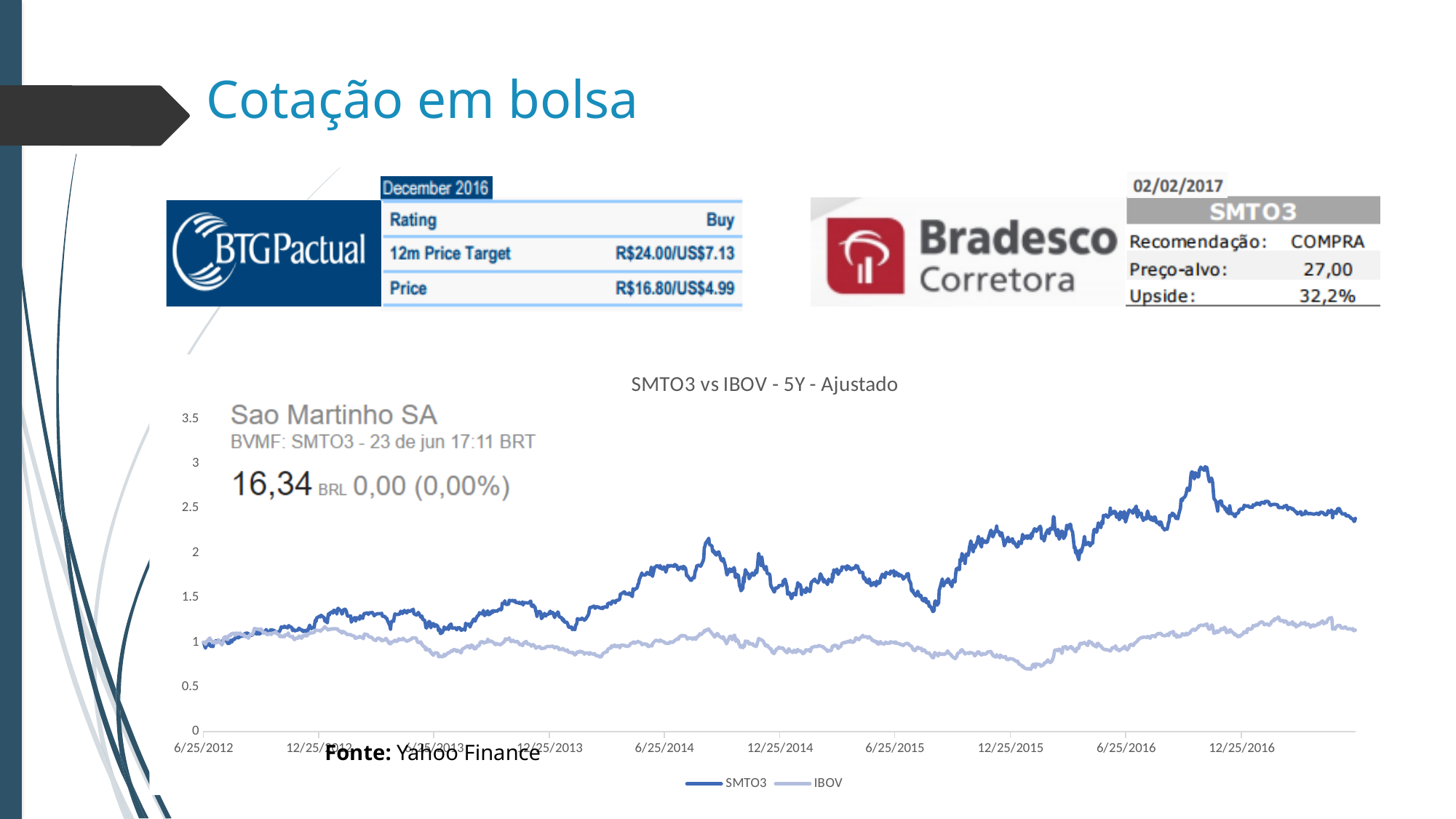
How many series does the legend of the chart list? 2 Is the value of SMTO3 at 6/25/2014 greater or less than 1.5? greater Which series is higher at the right end of the chart, SMTO3 or IBOV? SMTO3 Is the value of SMTO3 at the right end of the chart greater or less than 2? greater Does the SMTO3 series overall rise or fall from 6/25/2012 to the end of the chart? rise Is the value of IBOV around 12/25/2015 greater or less than 1? less What is the highest tick value shown on the y axis of the chart? 3.5 What kind of chart is shown on the slide? line chart Which series reaches the highest value on the chart? SMTO3 What is the title of the chart? SMTO3 vs IBOV - 5Y - Ajustado Which two series are listed in the chart legend? SMTO3 and IBOV